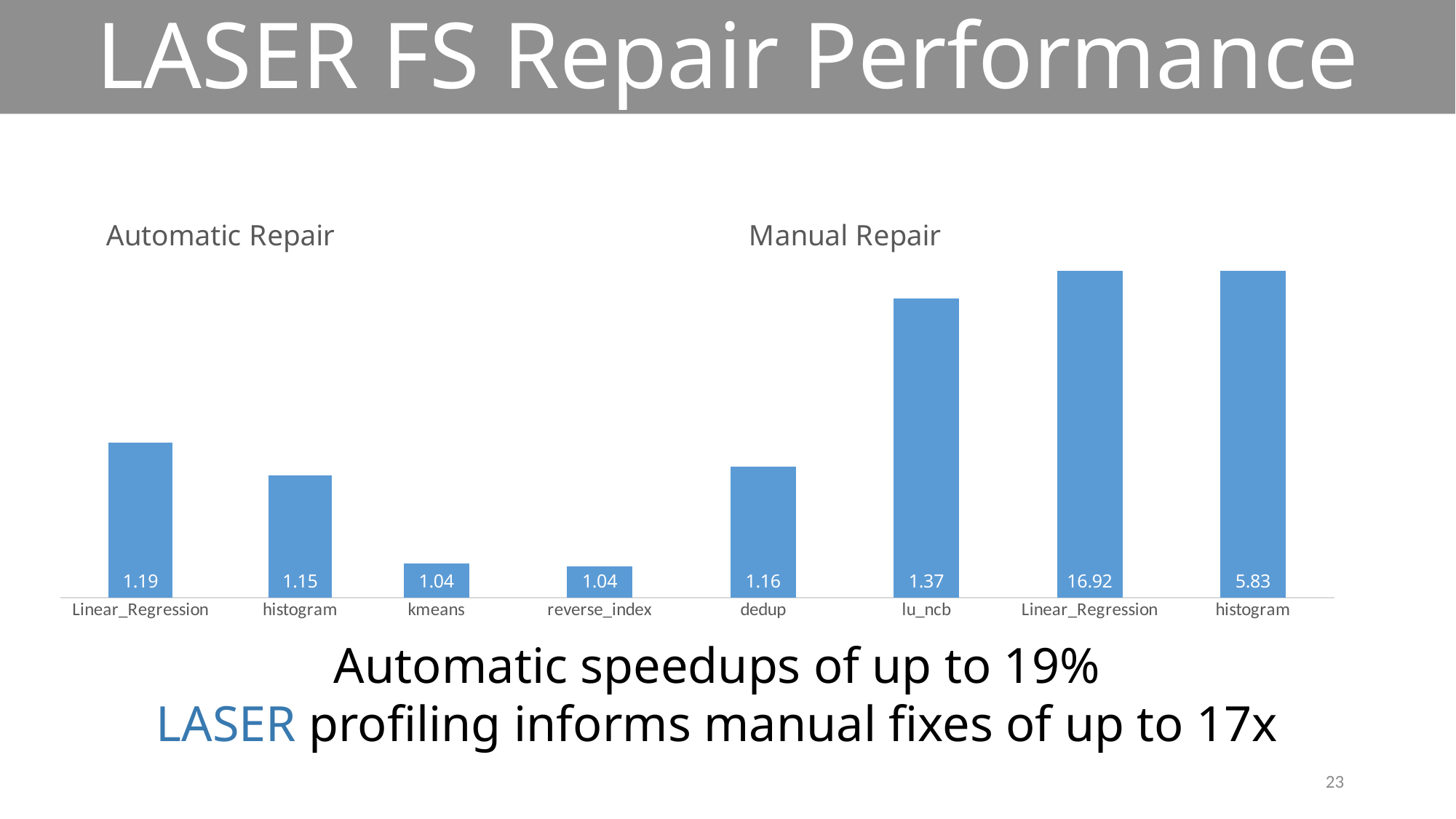
What is the value for kmeans under Automatic Repair? 1.04 What is the value for histogram under Automatic Repair? 1.15 Which is larger: the Automatic Repair value for Linear_Regression or the Manual Repair value for dedup? Linear_Regression (Automatic Repair) What is the difference between the Manual Repair Linear_Regression value and the Manual Repair histogram value? 11.09 How many bars are plotted on the chart? 8 What is the value for Linear_Regression under Manual Repair? 16.92 Which bar has the highest value on the chart? Linear_Regression (Manual Repair) What are the two group labels shown above the chart? Automatic Repair and Manual Repair What kind of chart is shown on the slide? Bar chart What is the value for dedup? 1.16 Which category has the highest value under Automatic Repair? Linear_Regression What is the value for lu_ncb under Manual Repair? 1.37